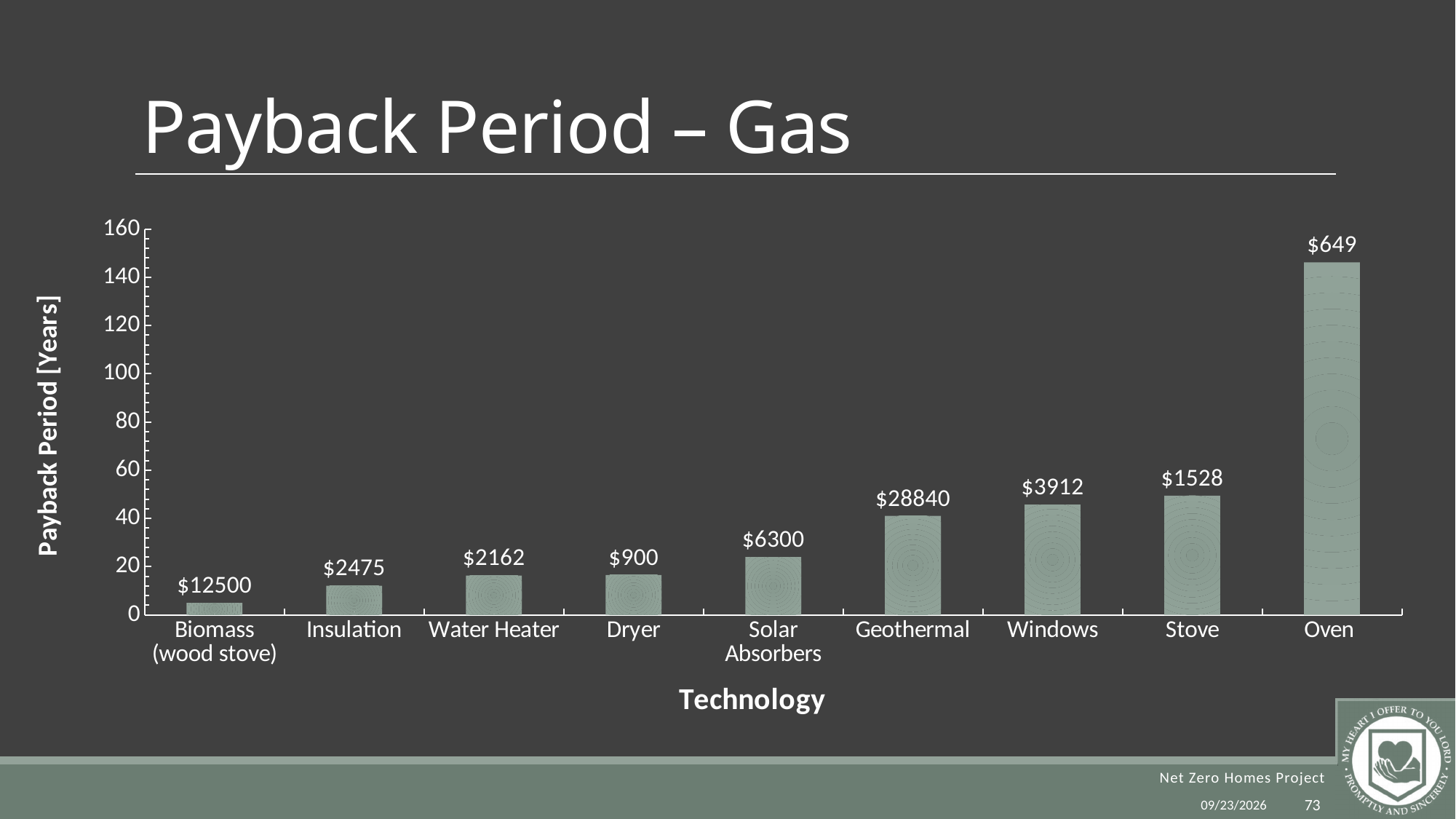
Is the payback period for Oven greater or less than 120 years? greater Is the payback period for Stove greater or less than 40 years? greater Which technology has the longest payback period in the chart? Oven What dollar label is printed above the Geothermal bar? $28840 Which has a longer payback period, Windows or Insulation? Windows What is the title of the vertical axis of the chart? Payback Period [Years] What dollar label is printed above the Oven bar? $649 What dollar label is printed above the Biomass (wood stove) bar? $12500 Which technology has the shortest payback period in the chart? Biomass (wood stove) What kind of chart is shown on the slide? bar chart How many technologies are shown on the x axis of the chart? 9 Is the payback period for Biomass (wood stove) greater or less than 20 years? less